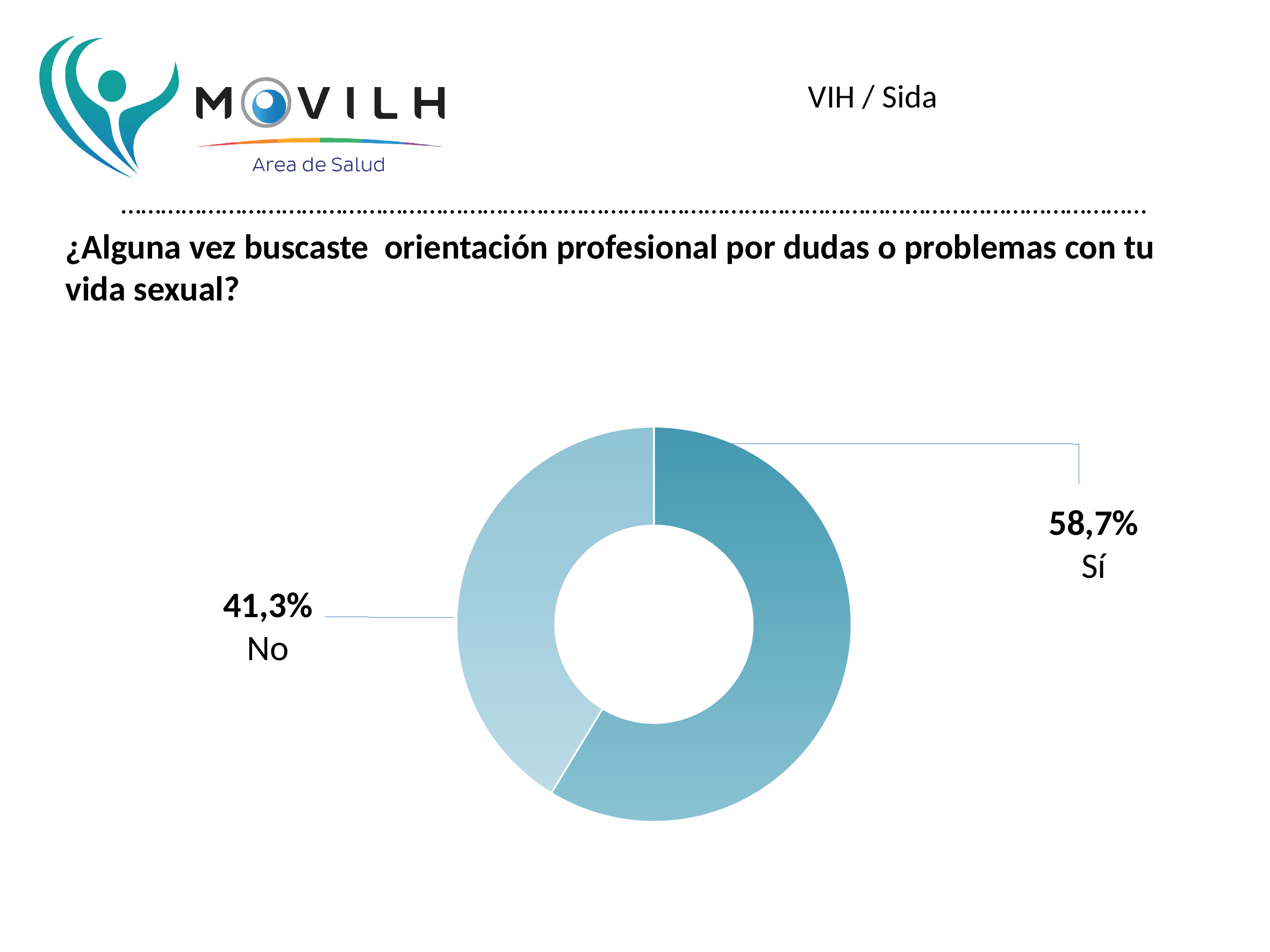
What is the difference in percentage points between the "Sí" and "No" shares? 17,4 What is the total of the two percentages shown in the chart? 100% What kind of chart is shown on the slide? Doughnut chart What percentage of respondents answered "Sí"? 58,7% Which slice is shown in the darker shade of blue, "Sí" or "No"? Sí What question does the chart on the slide answer? ¿Alguna vez buscaste orientación profesional por dudas o problemas con tu vida sexual? Which category has the smallest share of the chart? No What share of the chart does the "No" slice represent? 41,3% Which category has the largest share of the chart? Sí How many categories are shown in the chart? 2 What percentage of respondents answered "No"? 41,3% Which is larger, the share for "Sí" or the share for "No"? Sí